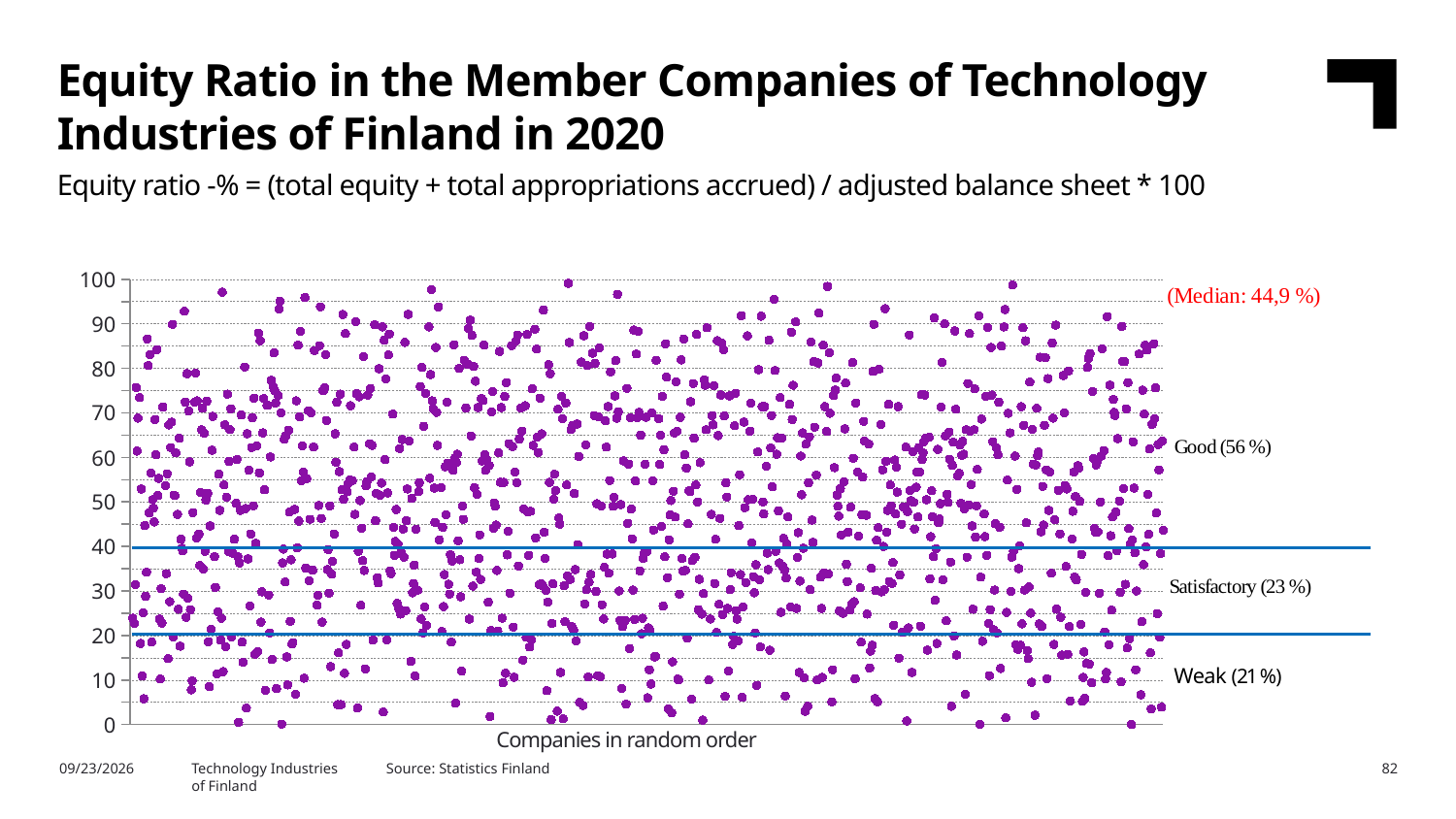
What kind of chart is shown on the slide? Scatter chart What share of companies falls into the Satisfactory category? 23 % What is the median equity ratio shown on the chart? 44,9 % Which category (Good, Satisfactory or Weak) contains the smallest share of companies? Weak What share of companies falls into the Weak category? 21 % What is the difference in percentage points between the Good share and the Satisfactory share? 33 % How many categories (Good, Satisfactory, Weak) are labelled on the chart? 3 Which share is larger, Satisfactory or Weak? Satisfactory What share of companies falls into the Good category? 56 % What is the highest value shown on the y axis? 100 Which category (Good, Satisfactory or Weak) contains the largest share of companies? Good What is the label of the x axis? Companies in random order